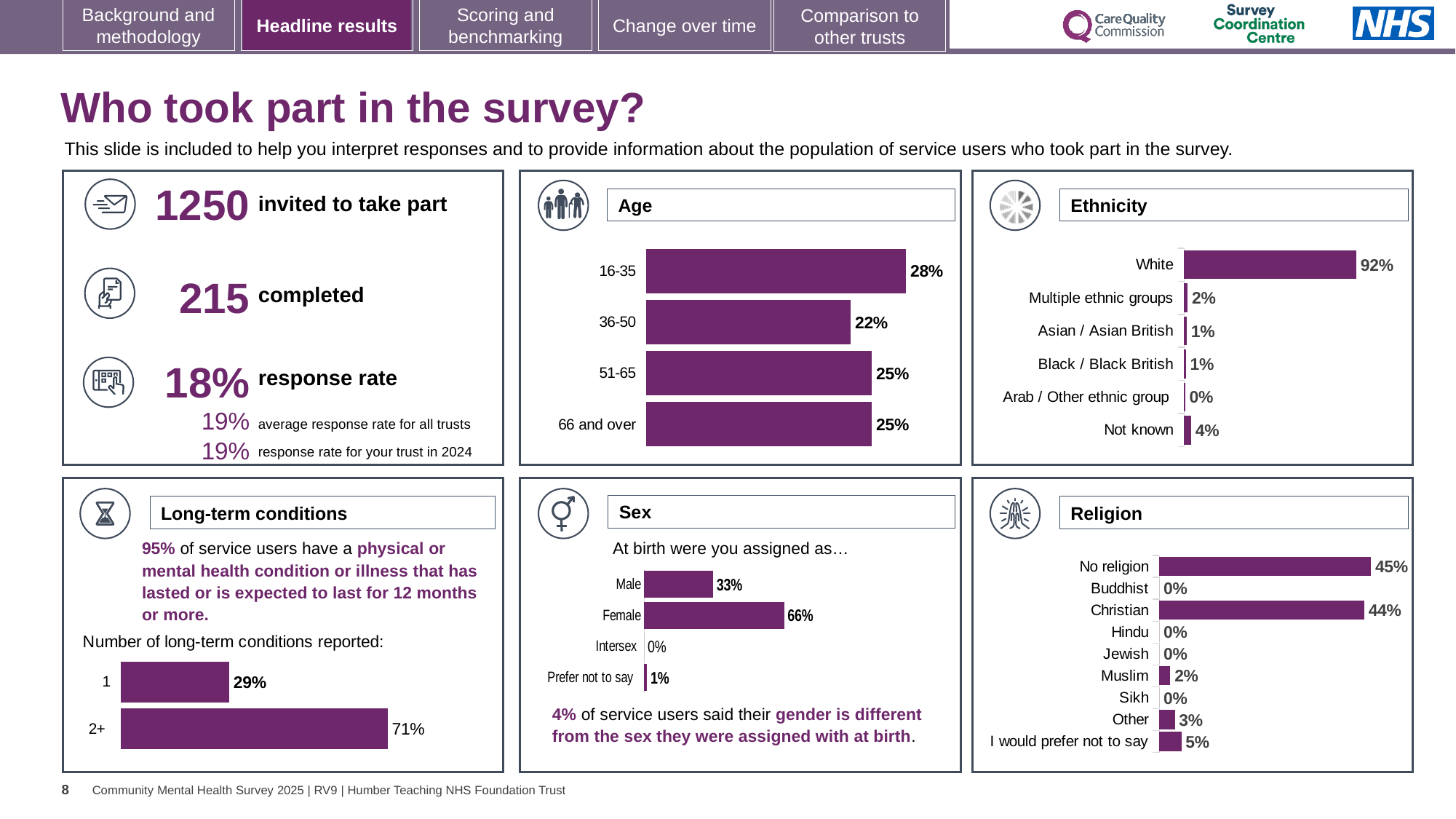
In the Age chart, what percentage of respondents were aged 16-35? 28% In the Sex chart, what percentage of respondents were assigned Female at birth? 66% What type of chart is used in the Religion panel? Bar chart In the Sex chart, which is larger, Male or Female? Female In the Ethnicity chart, what percentage of respondents were White? 92% In the Age chart, how many age categories are shown? 4 In the Ethnicity chart, how many ethnicity categories are listed? 6 In the Religion chart, what is the difference between No religion and Christian? 1% In the Long-term conditions chart, what percentage of service users reported 2+ long-term conditions? 71% In the Religion chart, what percentage of respondents reported No religion? 45% In the Ethnicity chart, what is the difference between the White and Not known percentages? 88% In the Age chart, which age group has the lowest percentage? 36-50